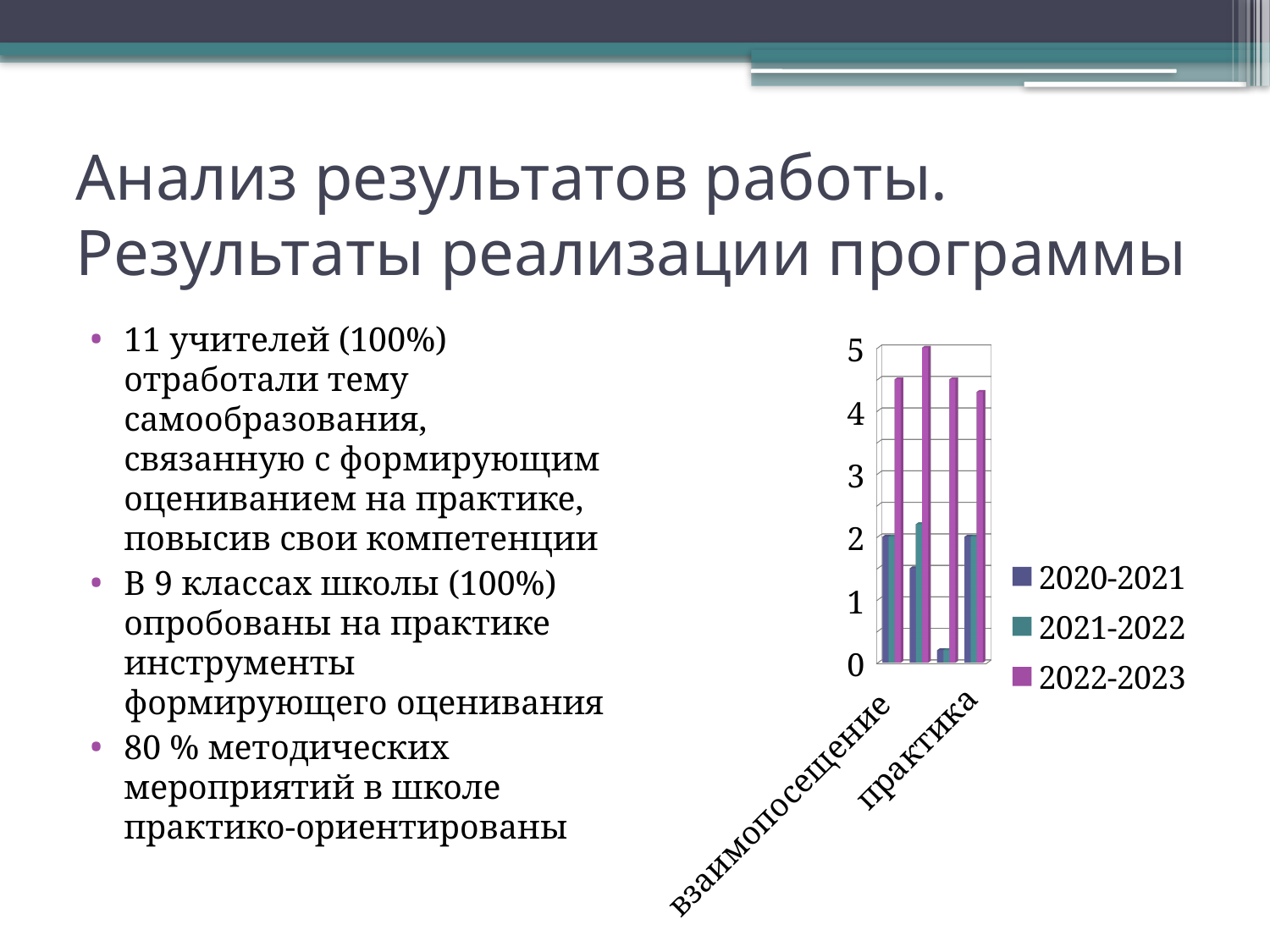
In the leftmost group of bars, which is larger: the 2020-2021 value or the 2022-2023 value? 2022-2023 How many series does the chart legend list? 3 Is the tallest bar in the chart greater or less than 4? greater How many groups of bars are plotted in the chart? 4 What kind of chart is shown on the slide? bar chart Which series has the tallest bar in every group of the chart? 2022-2023 Which series are listed in the chart legend? 2020-2021, 2021-2022, 2022-2023 Is the value for 2022-2023 in the leftmost group of bars greater or less than 4? greater Is the value for 2020-2021 in the leftmost group of bars greater or less than 3? less What is the highest value shown on the chart's vertical axis? 5 Which series has the lowest bars across the chart? 2020-2021